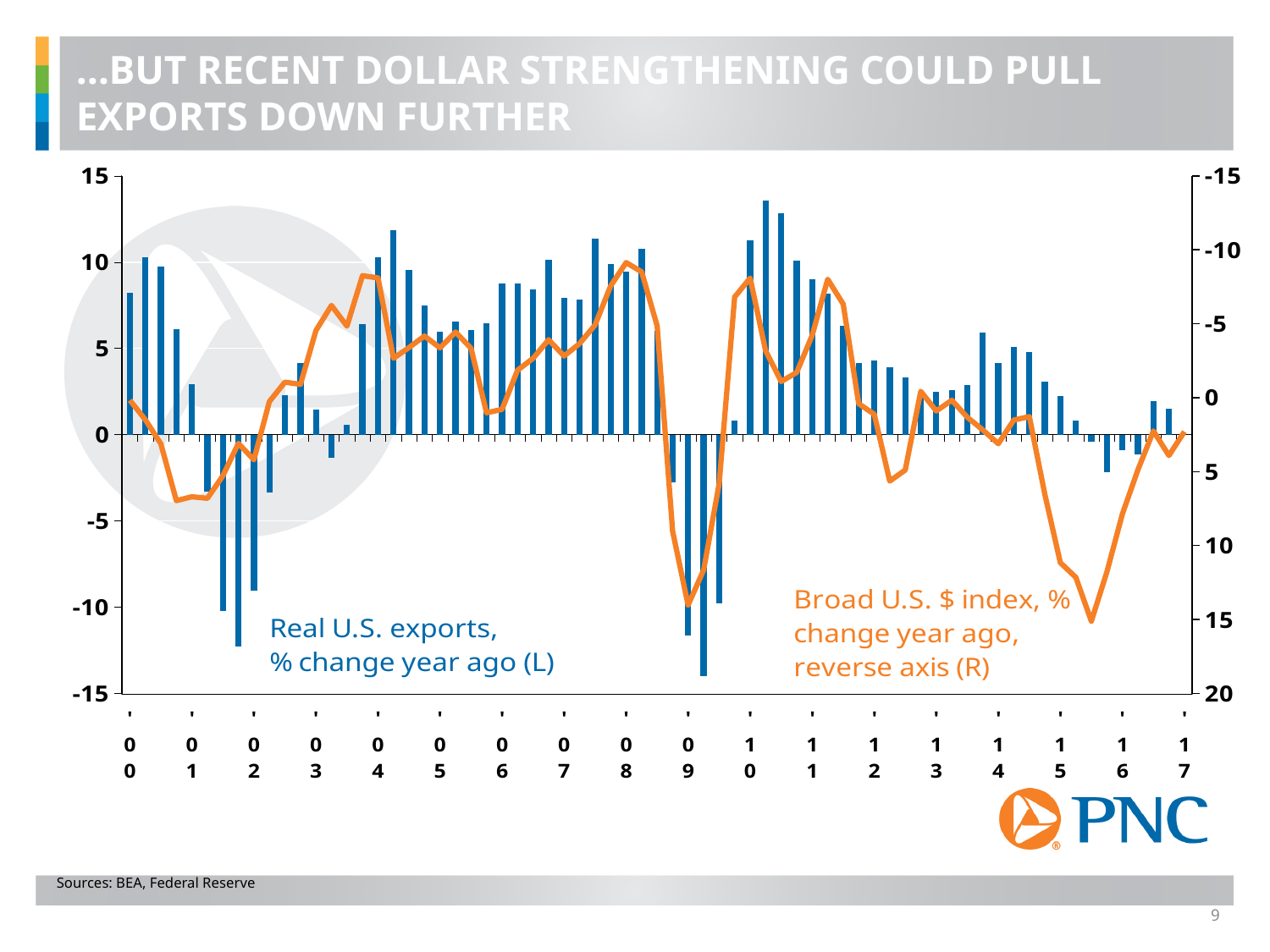
Which series is plotted as blue bars? Real U.S. exports, % change year ago (L) In which year does the real U.S. exports series reach its highest bar? 2010 How many year labels are shown along the x axis? 18 Is the peak of the Broad U.S. $ index line in 2015 greater or less than 10 on the right axis? greater What kind of chart is shown on the slide? A combined bar and line chart How many data series are plotted on the chart? 2 Which series is plotted as the orange line? Broad U.S. $ index, % change year ago, reverse axis (R) Is the highest value of real U.S. exports in 2010 greater or less than 10? greater Is the lowest value of real U.S. exports in 2009 greater or less than -10? less In which year does the real U.S. exports series reach its lowest bar? 2009